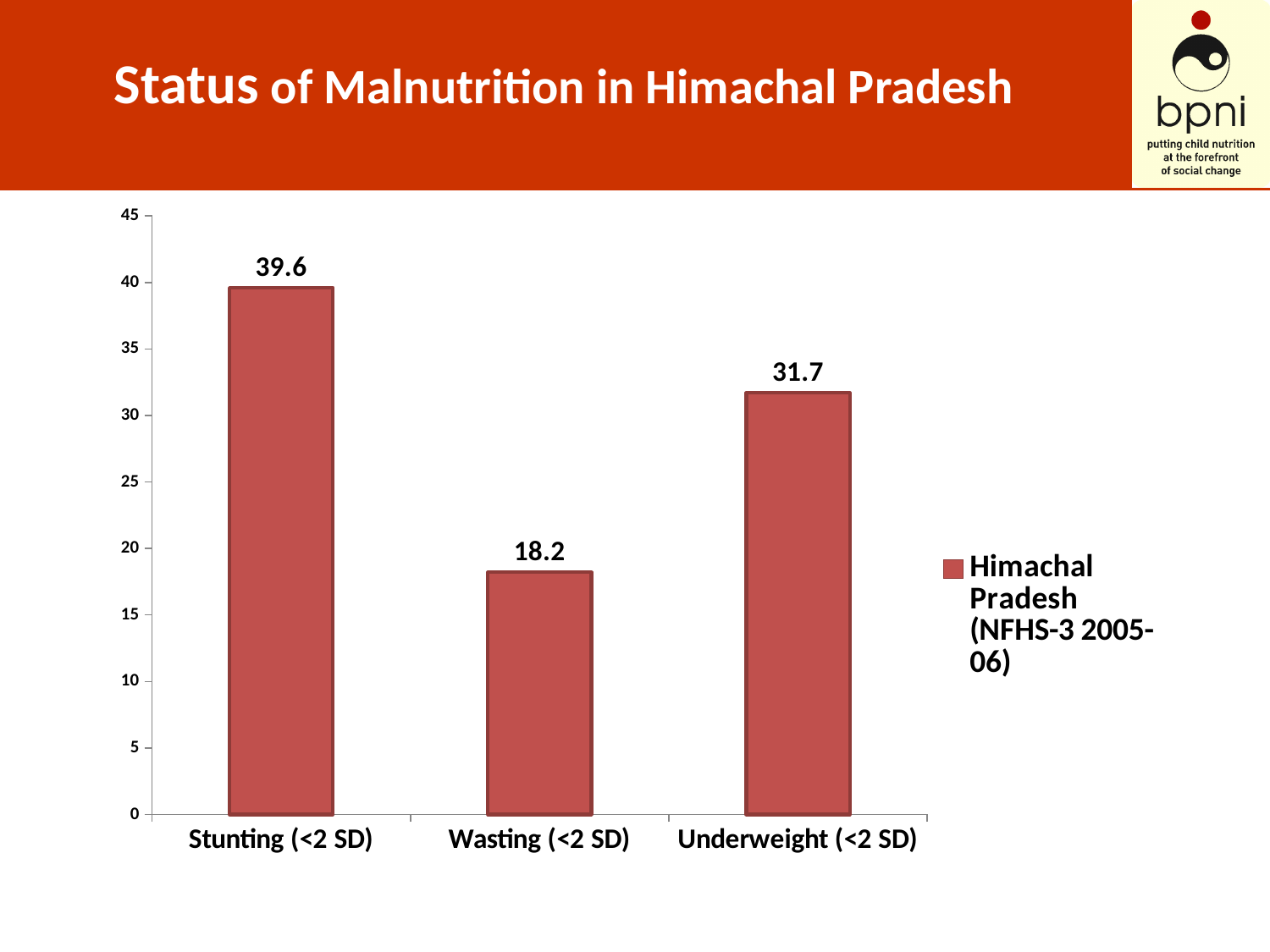
What series does the legend list? Himachal Pradesh (NFHS-3 2005-06) What is the difference between the values for Stunting (<2 SD) and Wasting (<2 SD)? 21.4 Is the value for Underweight (<2 SD) greater or less than 30? greater Which category has the highest value? Stunting (<2 SD) Which category has the lowest value? Wasting (<2 SD) Which is larger, the value for Underweight (<2 SD) or the value for Wasting (<2 SD)? Underweight (<2 SD) What kind of chart is shown on the slide? bar chart What is the value for Underweight (<2 SD)? 31.7 How many categories are shown on the x axis? 3 What is the value for Wasting (<2 SD)? 18.2 What is the difference between the values for Stunting (<2 SD) and Underweight (<2 SD)? 7.9 What is the value for Stunting (<2 SD)? 39.6